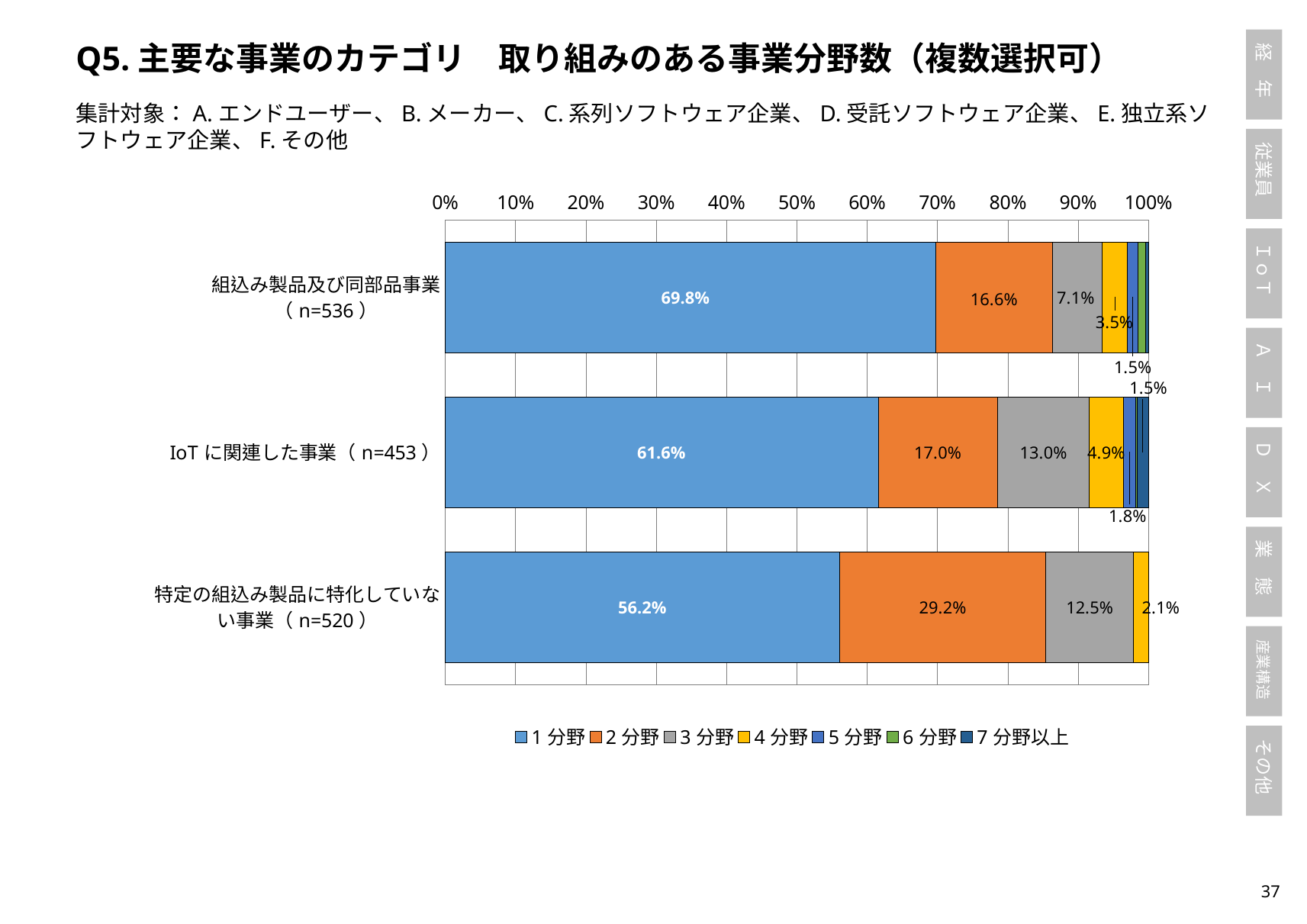
What is the value of 4 分野 for IoT に関連した事業 (n=453)? 4.9% What is the value of 2 分野 for IoT に関連した事業 (n=453)? 17.0% Which business category has the highest share for 1 分野? 組込み製品及び同部品事業 (n=536) What kind of chart is shown on the slide? Stacked bar chart What is the value of 3 分野 for 特定の組込み製品に特化していない事業 (n=520)? 12.5% How many series does the legend list? 7 What is the difference between the 2 分野 values for 特定の組込み製品に特化していない事業 and 組込み製品及び同部品事業? 12.6% What is the value of 1 分野 for 組込み製品及び同部品事業 (n=536)? 69.8% Which is larger: the 3 分野 value for IoT に関連した事業 or for 組込み製品及び同部品事業? IoT に関連した事業 Is the 1 分野 value for IoT に関連した事業 greater or less than 60%? greater Which business category has the lowest share for 1 分野? 特定の組込み製品に特化していない事業 (n=520) How many business categories (bars) are plotted in the chart? 3